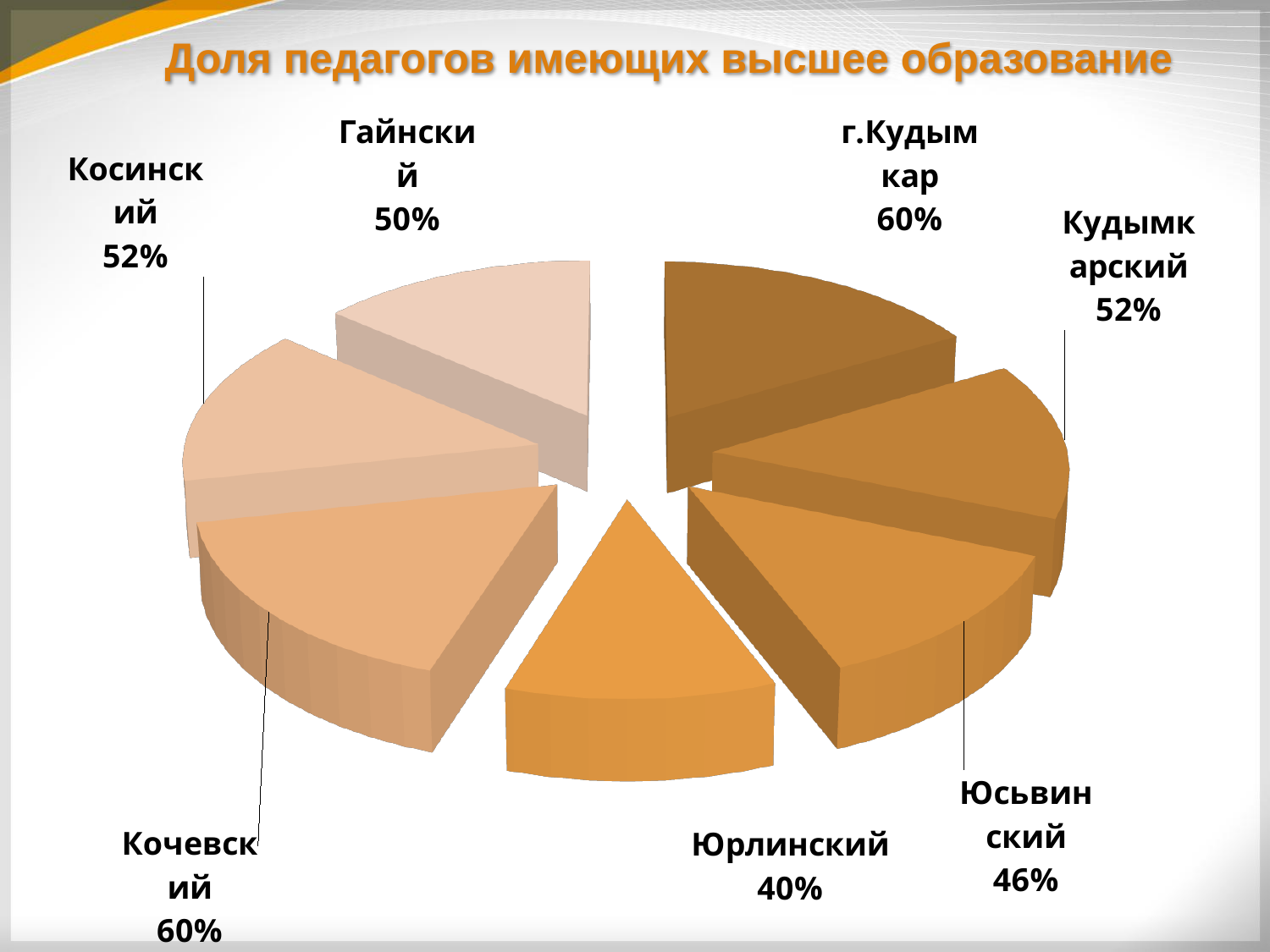
What is the value shown for Юрлинский? 40% What is the difference between the values for Косинский and Юсьвинский? 6% What is the difference between the values for г.Кудымкар and Юрлинский? 20% Which category has the lowest value? Юрлинский What is the value shown for Юсьвинский? 46% Which has a larger value, Кочевский or Гайнский? Кочевский What is the value shown for Гайнский? 50% What is the title of the chart? Доля педагогов имеющих высшее образование How many categories (districts) are shown in the pie chart? 7 What kind of chart is shown on the slide? pie chart What is the value shown for г.Кудымкар? 60% Which has a larger value, Юсьвинский or Кудымкарский? Кудымкарский